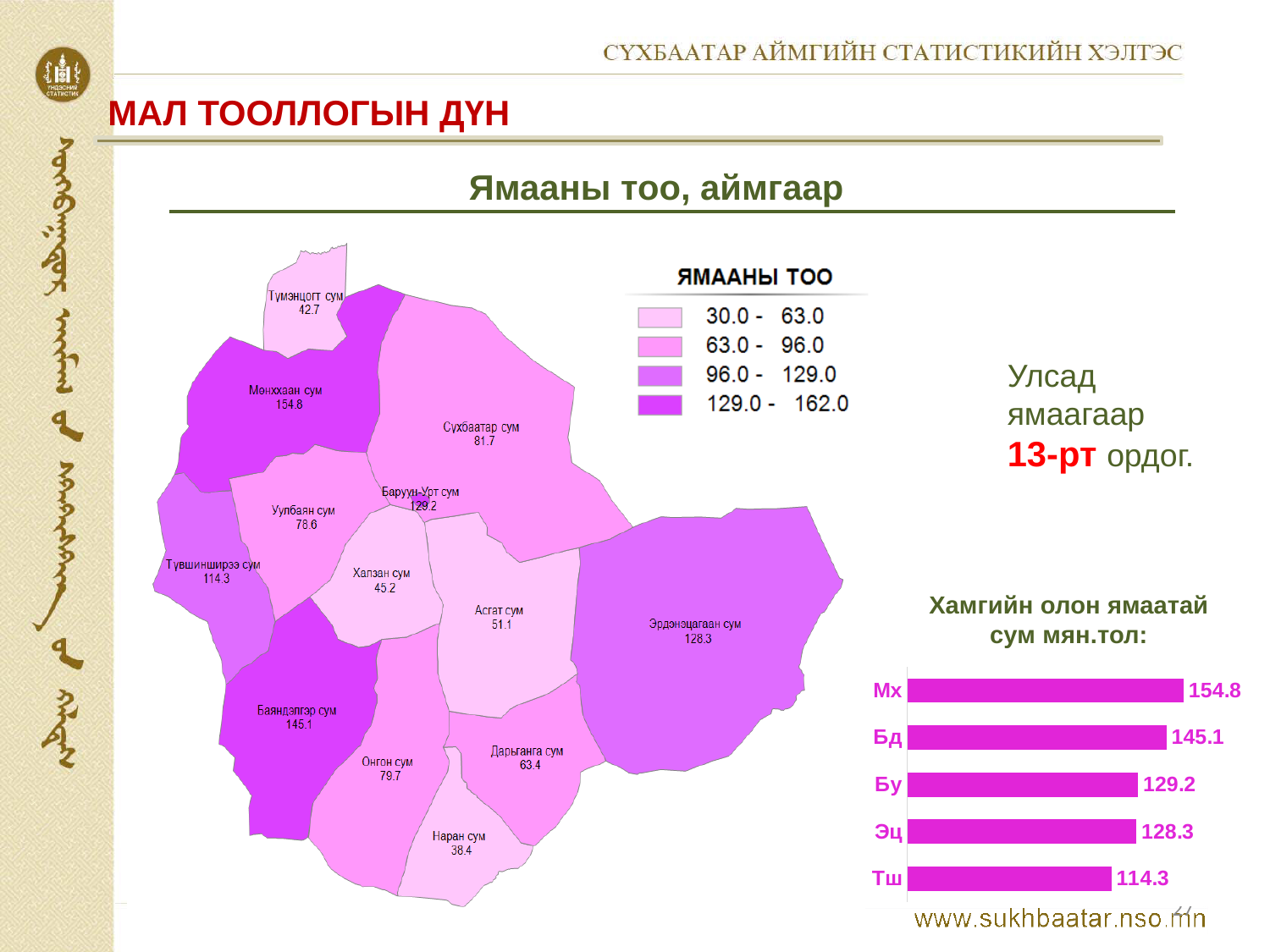
In the bar chart titled 'Хамгийн олон ямаатай сум мян.тол:', what is the value for Тш? 114.3 On the map titled 'Ямааны тоо, аймгаар', what value is shown for Эрдэнэцагаан сум? 128.3 In the bar chart titled 'Хамгийн олон ямаатай сум мян.тол:', which category has the highest value? Мх In the bar chart titled 'Хамгийн олон ямаатай сум мян.тол:', what is the value for Бу? 129.2 What kind of chart is the one titled 'Хамгийн олон ямаатай сум мян.тол:'? Bar chart In the bar chart titled 'Хамгийн олон ямаатай сум мян.тол:', which is larger, the value for Бд or the value for Эц? Бд In the bar chart titled 'Хамгийн олон ямаатай сум мян.тол:', do the values rise or fall from the top bar to the bottom bar? Fall On the map titled 'Ямааны тоо, аймгаар', how many value ranges does the legend 'ЯМААНЫ ТОО' list? 4 In the bar chart titled 'Хамгийн олон ямаатай сум мян.тол:', what is the difference between the values for Мх and Бд? 9.7 In the bar chart titled 'Хамгийн олон ямаатай сум мян.тол:', which category has the lowest value? Тш How many categories are shown in the bar chart titled 'Хамгийн олон ямаатай сум мян.тол:'? 5 In the bar chart titled 'Хамгийн олон ямаатай сум мян.тол:', what is the value for Мх? 154.8